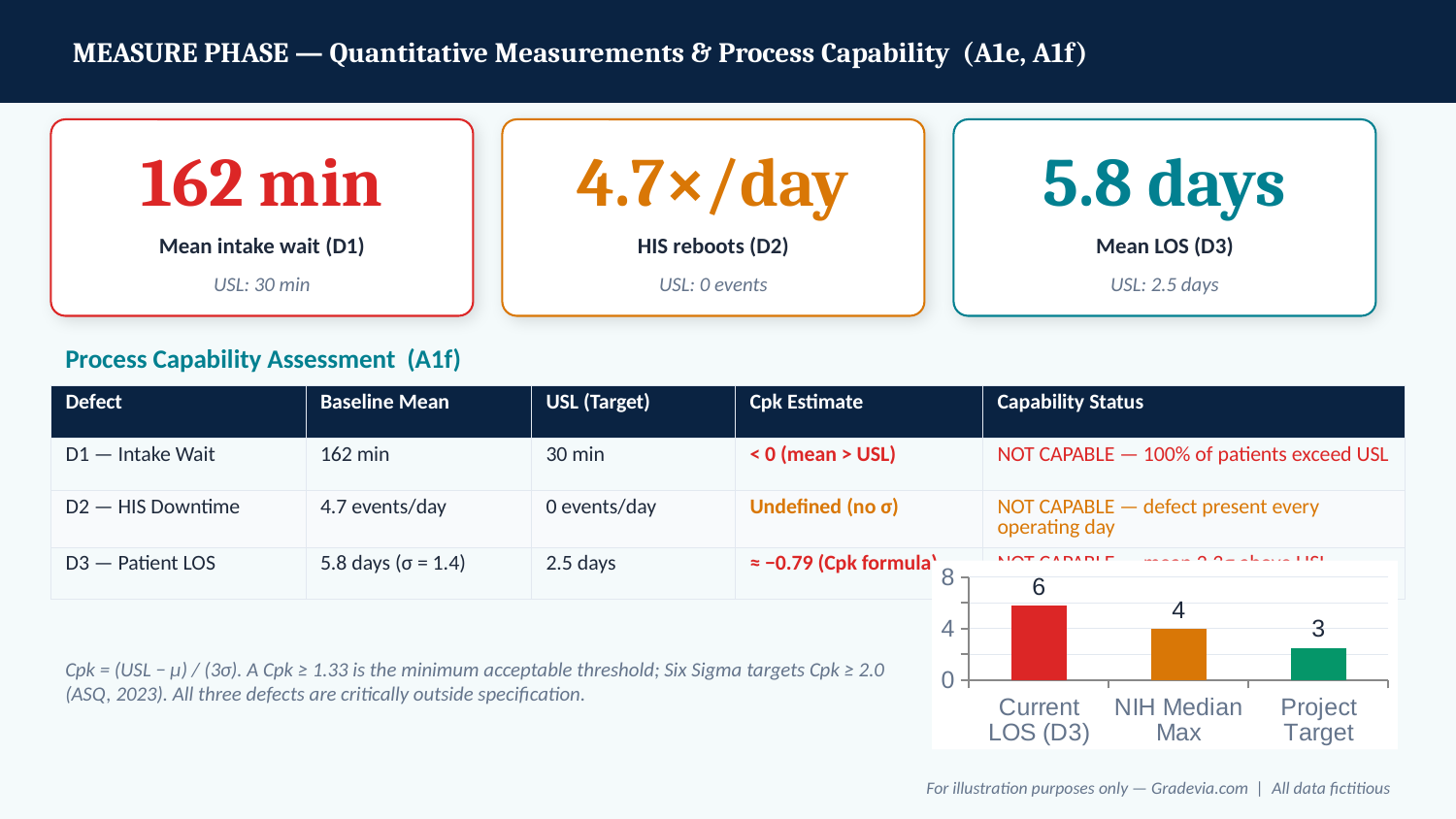
Is the value for Current LOS (D3) in the bar chart greater or less than 4? greater Which category has the highest value in the bar chart? Current LOS (D3) What kind of chart is shown at the bottom right of the slide? Bar chart In the bar chart, which is larger: Current LOS (D3) or NIH Median Max? Current LOS (D3) How many categories are shown in the bar chart? 3 Do the values in the bar chart rise or fall from left to right? Fall What is the value for NIH Median Max in the bar chart? 4 What is the value for Current LOS (D3) in the bar chart? 6 What is the difference between the NIH Median Max value and the Project Target value in the bar chart? 1 What is the difference between the Current LOS (D3) value and the Project Target value in the bar chart? 3 Which category has the lowest value in the bar chart? Project Target What is the value for Project Target in the bar chart? 3